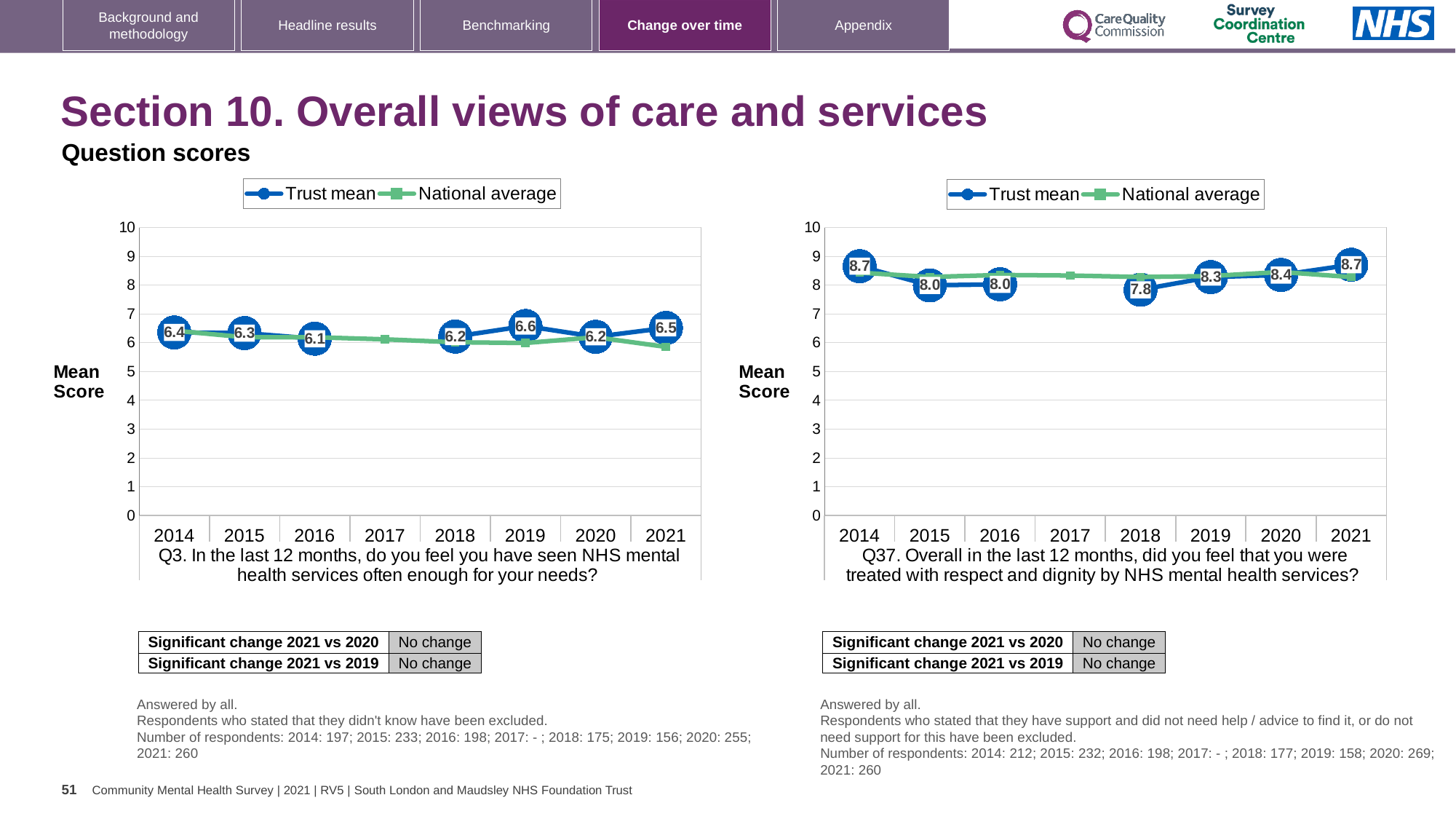
How many series does the legend of the Q3 chart on the left list? 2 In the Q3 chart on the left, what is the difference between the Trust mean scores for 2019 and 2016? 0.5 In the Q37 chart on the right, what is the Trust mean score for 2020? 8.4 In the Q37 chart on the right, what is the Trust mean score for 2018? 7.8 In the Q3 chart on the left, is the National average value for 2021 greater or less than 6? less In the Q37 chart on the right, which year has the lowest labelled Trust mean score? 2018 What kind of chart is the Q37 chart on the right? Line chart In the Q37 chart on the right, is the Trust mean score for 2015 or 2019 higher? 2019 In the Q3 chart on the left, what is the Trust mean score for 2021? 6.5 In the Q37 chart on the right, what is the difference between the Trust mean scores for 2021 and 2018? 0.9 In the Q3 chart on the left, what is the Trust mean score for 2019? 6.6 In the Q3 chart on the left, which year has the lowest labelled Trust mean score? 2016